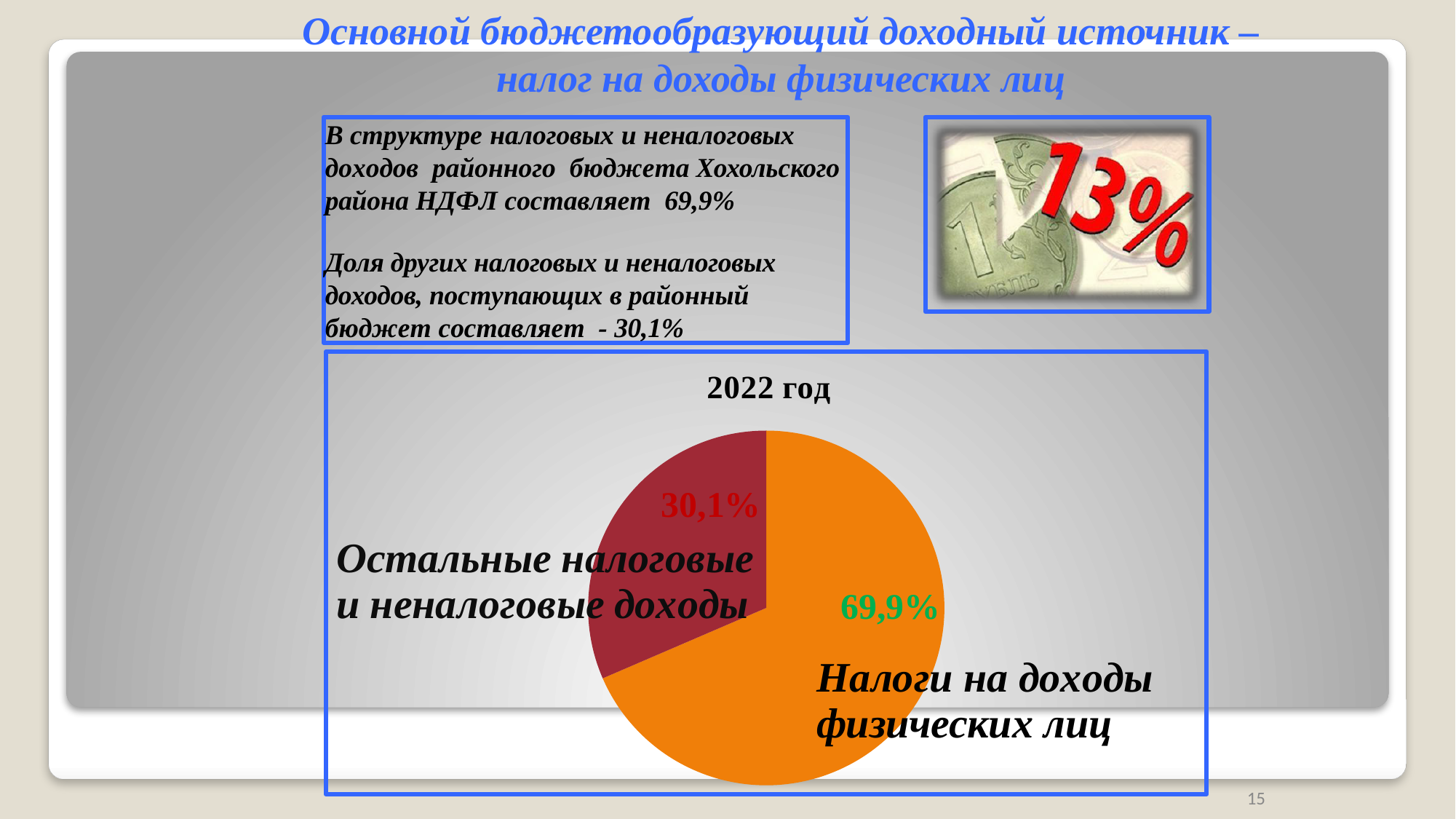
How many slices does the pie chart have? 2 What kind of chart is shown on the slide? pie chart What colour is the slice for "Налоги на доходы физических лиц"? orange Which is larger: the share for "Налоги на доходы физических лиц" or the share for "Остальные налоговые и неналоговые доходы"? Налоги на доходы физических лиц What share of the pie is labelled "Налоги на доходы физических лиц"? 69,9% What is the total of the two slices shown in the pie chart? 100% What is the difference in percentage points between the "Налоги на доходы физических лиц" slice and the "Остальные налоговые и неналоговые доходы" slice? 39,8 What share of the pie is labelled "Остальные налоговые и неналоговые доходы"? 30,1% What is the title of the pie chart? 2022 год Which slice of the pie chart is the smallest? Остальные налоговые и неналоговые доходы Which slice of the pie chart is the largest? Налоги на доходы физических лиц